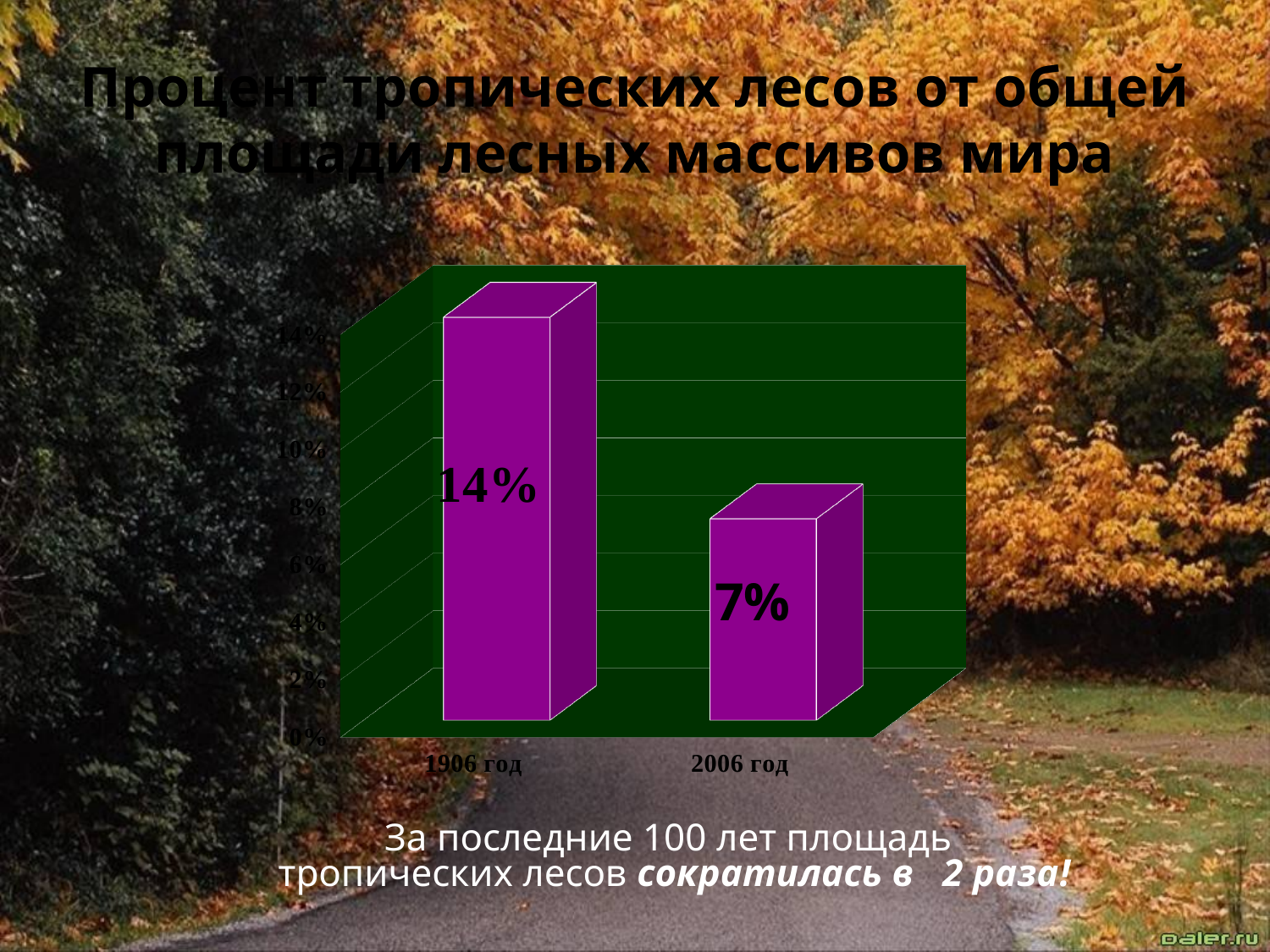
What is the value for 2006 год? 7% What kind of chart is shown on the slide? bar chart What is the value for 1906 год? 14% Which category has the lowest value? 2006 год What is the difference between the values for 1906 год and 2006 год? 7% Do the values rise or fall from 1906 год to 2006 год? fall Is the value for 2006 год greater or less than 10%? less Which is larger, the value for 1906 год or the value for 2006 год? 1906 год What colour are the bars on the chart? purple How many categories are shown on the chart? 2 Is the value for 1906 год greater or less than 12%? greater Which category has the highest value? 1906 год